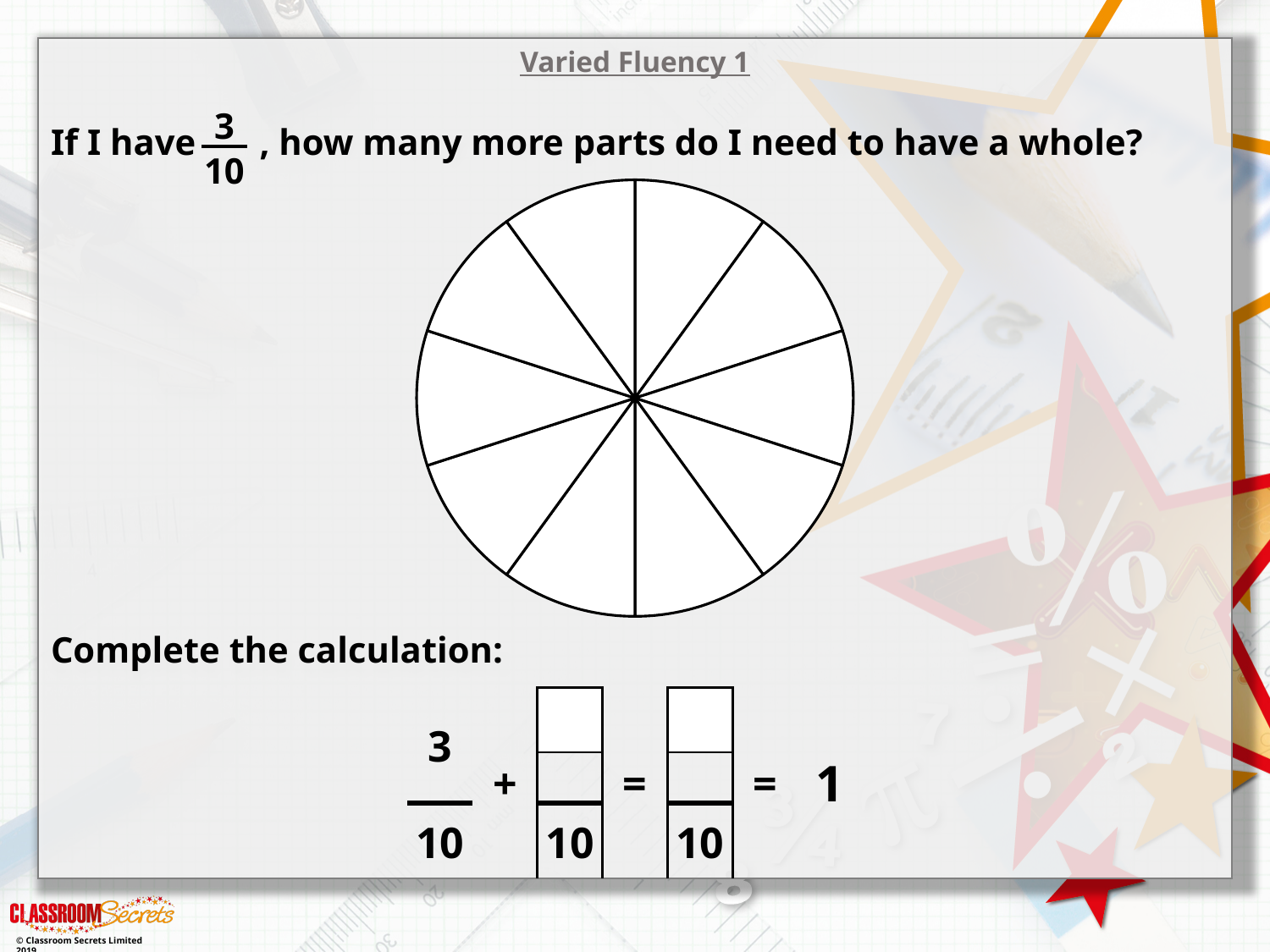
What denominator appears in every fraction in the calculation below the circle? 10 What fraction does each single part of the circle represent? 1/10 How many equal parts is the circle on the slide divided into? 10 How many of the circle's parts are shaded? 0 What is the title shown at the top of the slide? Varied Fluency 1 What kind of chart or diagram is shown in the middle of the slide? A circle (pie) divided into equal parts